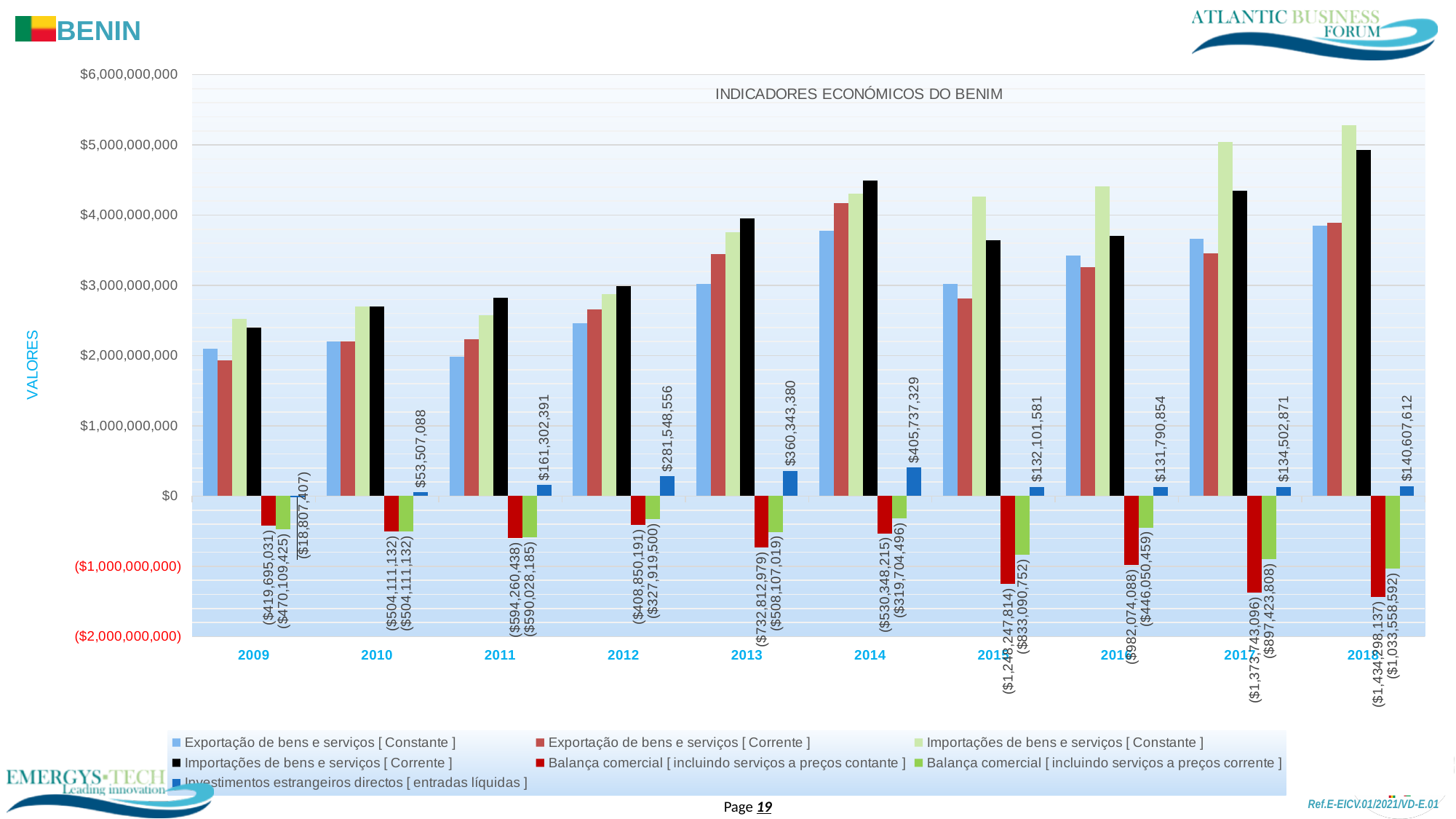
How many series does the legend list? 7 How many years are shown on the x axis? 10 In which year is Investimentos estrangeiros directos [ entradas líquidas ] lowest? 2009 Is the value for Importações de bens e serviços [ Corrente ] in 2018 greater or less than $4,000,000,000? greater What is the title of the chart? INDICADORES ECONÓMICOS DO BENIM What is the difference between Investimentos estrangeiros directos [ entradas líquidas ] in 2014 and in 2013? $45,393,949 What kind of chart is shown on the slide? bar chart What is the value of Balança comercial [ incluindo serviços a preços corrente ] in 2015? ($833,090,752) What is the value of Balança comercial [ incluindo serviços a preços contante ] in 2018? ($1,434,298,137) What is the value of Investimentos estrangeiros directos [ entradas líquidas ] in 2014? $405,737,329 In which year is Investimentos estrangeiros directos [ entradas líquidas ] highest? 2014 Which is larger: Investimentos estrangeiros directos [ entradas líquidas ] in 2012 or in 2013? 2013